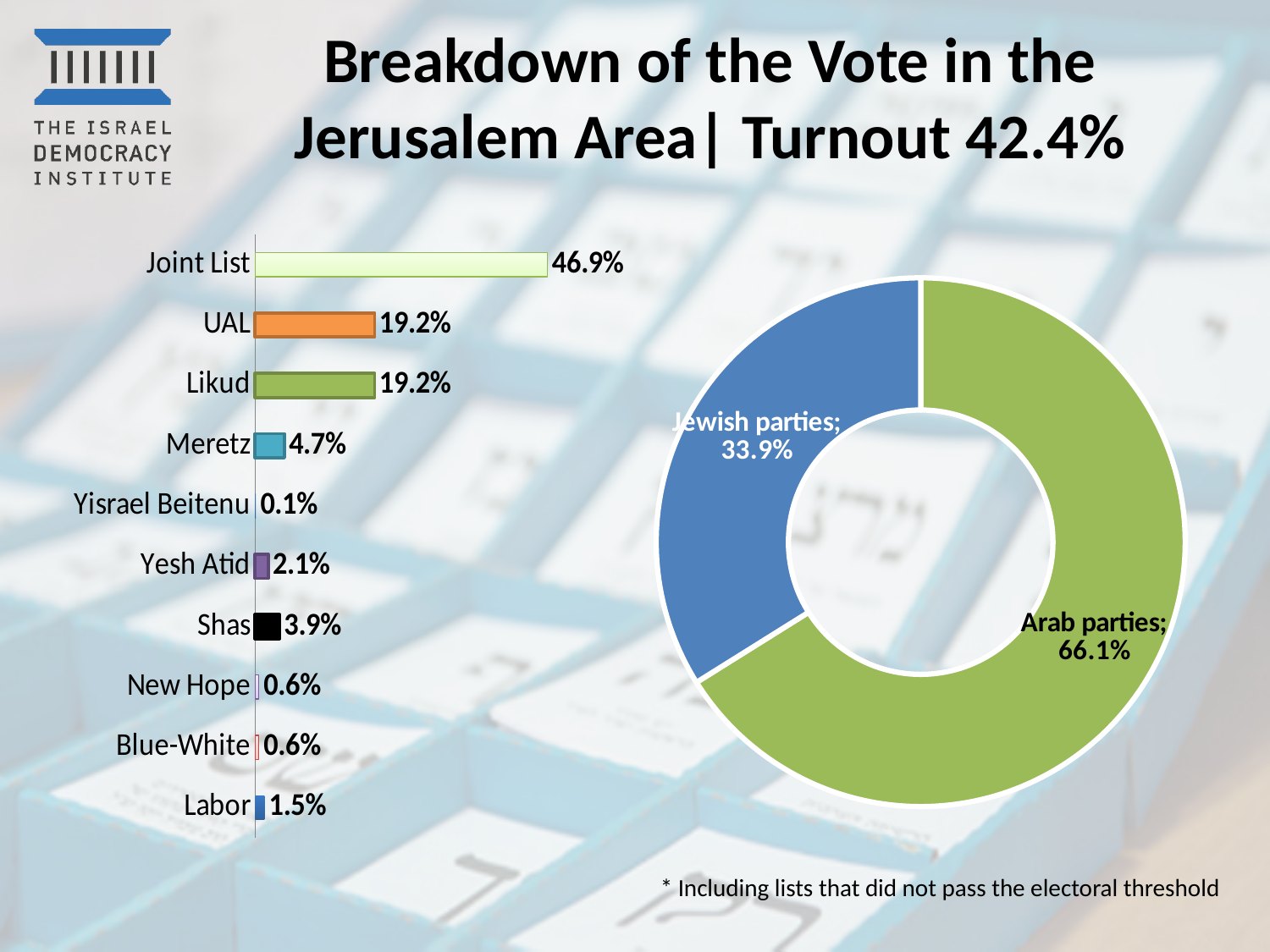
In the doughnut chart on the right, what share do Arab parties have? 66.1% In the bar chart on the left, what is the value for Joint List? 46.9% In the bar chart on the left, which party has the highest value? Joint List In the doughnut chart on the right, what share do Jewish parties have? 33.9% What turnout figure is given in the slide title? 42.4% In the bar chart on the left, what is the value for Shas? 3.9% In the bar chart on the left, what is the difference between the values for Joint List and UAL? 27.7% In the bar chart on the left, which is larger, the value for Meretz or the value for Yesh Atid? Meretz What kind of chart is on the left side of the slide? Bar chart In the bar chart on the left, which party has the lowest value? Yisrael Beitenu In the bar chart on the left, what is the value for Meretz? 4.7% How many parties are shown in the bar chart on the left? 10